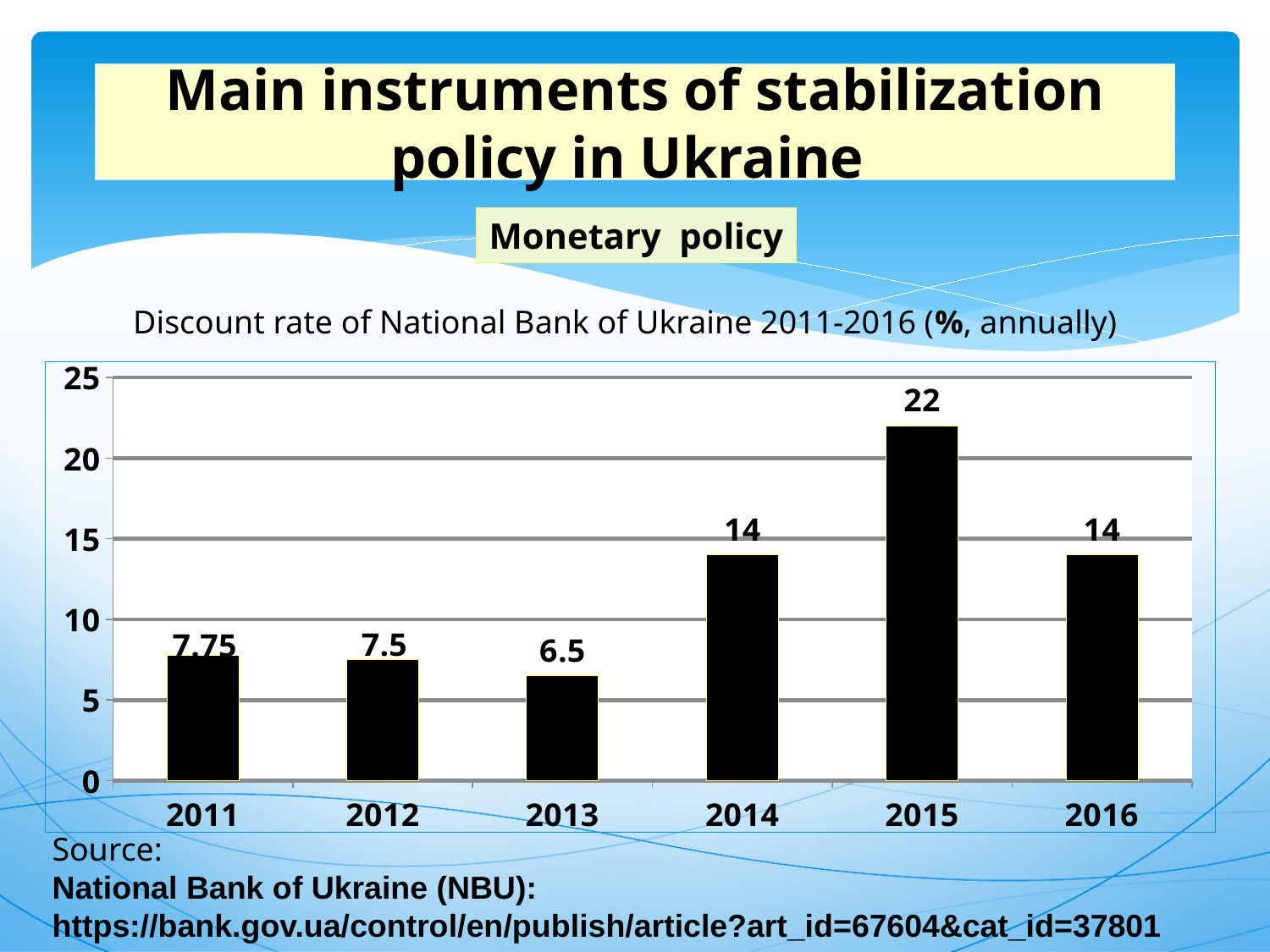
How many years are shown on the x axis of the chart? 6 Which year has a higher discount rate, 2012 or 2014? 2014 What is the title of the chart? Discount rate of National Bank of Ukraine 2011-2016 (%, annually) What is the discount rate shown for 2013? 6.5 Which year has the highest discount rate? 2015 What is the difference between the discount rate in 2011 and in 2012? 0.25 What is the discount rate shown for 2011? 7.75 What kind of chart is shown on the slide? bar chart Is the value for 2015 greater or less than 20? greater What is the difference between the discount rate in 2015 and in 2014? 8 Which year has the lowest discount rate? 2013 What is the discount rate shown for 2015? 22